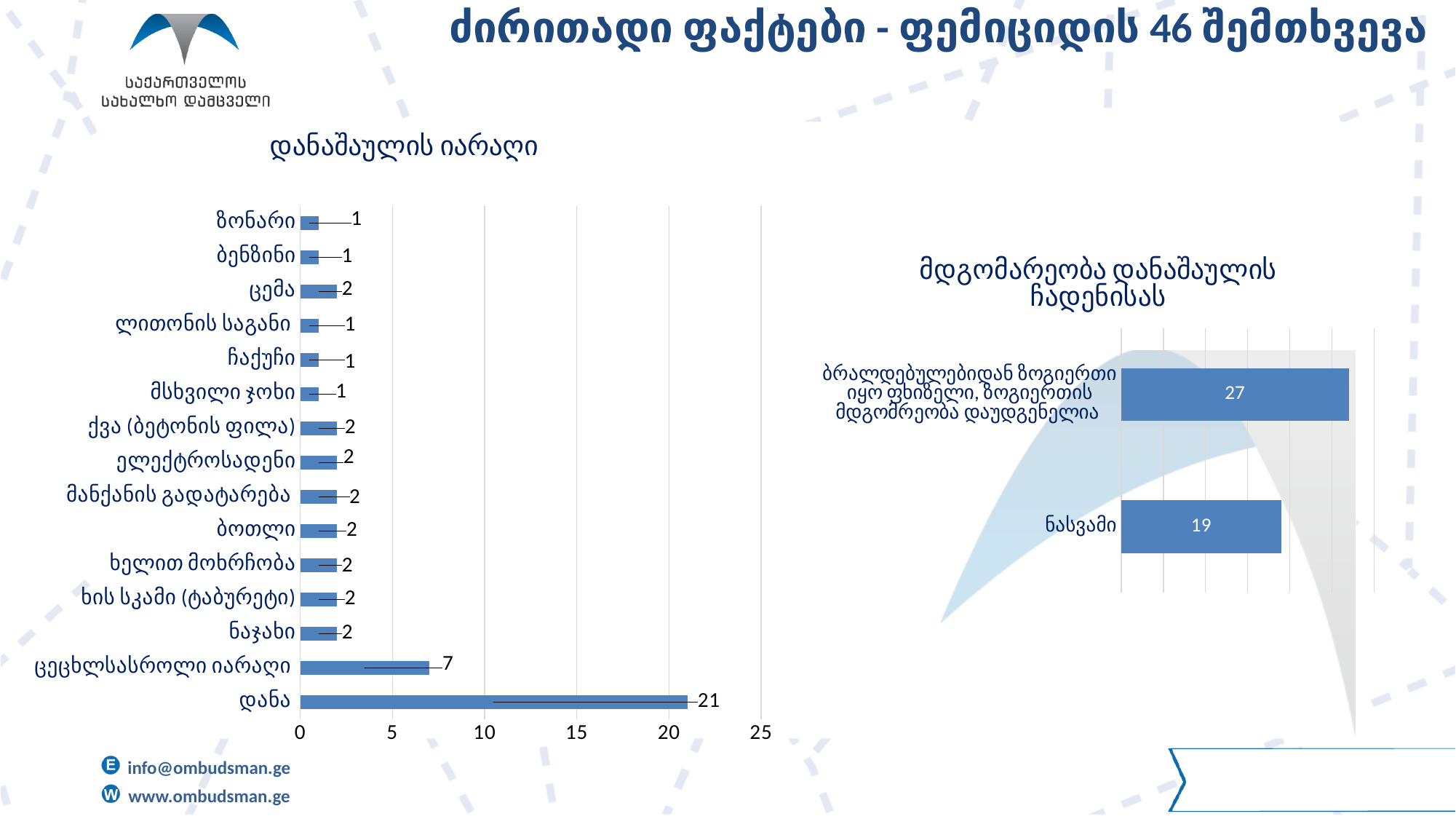
In the chart titled "მდგომარეობა დანაშაულის ჩადენისას", which of the two bars has the larger value? ბრალდებულებიდან ზოგიერთი იყო ფხიზელი, ზოგიერთის მდგომრეობა დაუდგენელია In the chart titled "დანაშაულის იარაღი", what is the value for "ცეცხლსასროლი იარაღი"? 7 In the chart titled "დანაშაულის იარაღი", which category has the highest value? დანა In the chart titled "დანაშაულის იარაღი", what is the value for "ნაჯახი"? 2 In the chart titled "დანაშაულის იარაღი", what is the value for "დანა"? 21 In the chart titled "მდგომარეობა დანაშაულის ჩადენისას", what is the value for "ნასვამი"? 19 In the chart titled "მდგომარეობა დანაშაულის ჩადენისას", what is the difference between the two bar values? 8 In the chart titled "დანაშაულის იარაღი", how many categories are shown? 15 In the chart titled "დანაშაულის იარაღი", is the value for "დანა" greater or less than 20? greater In the chart titled "მდგომარეობა დანაშაულის ჩადენისას", how many bars are shown? 2 In the chart titled "დანაშაულის იარაღი", what is the difference between the values for "დანა" and "ცეცხლსასროლი იარაღი"? 14 What kind of chart is the chart titled "დანაშაულის იარაღი"? bar chart